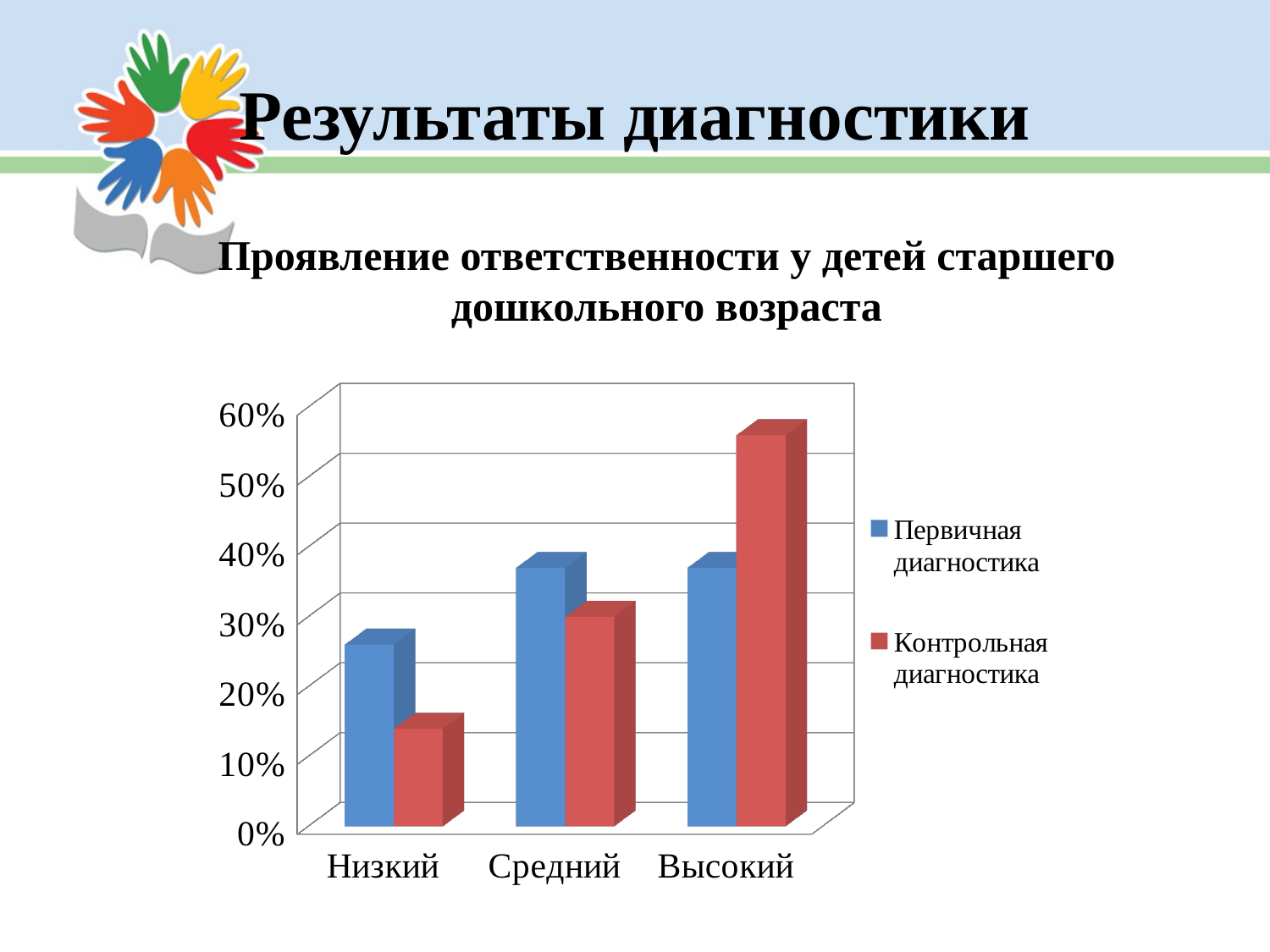
What colour are the bars for Контрольная диагностика in the chart? red Which category has the lowest value for Первичная диагностика? Низкий Is the value for Контрольная диагностика in the Высокий category greater or less than 50%? greater Which category has the lowest value for Контрольная диагностика? Низкий How many series does the chart's legend list? 2 For the Низкий category, which series has the larger value: Первичная диагностика or Контрольная диагностика? Первичная диагностика Which category has the highest value for Контрольная диагностика? Высокий Is the value for Первичная диагностика in the Средний category greater or less than 30%? greater How many categories are shown on the x axis of the chart? 3 Is the value for Контрольная диагностика in the Низкий category greater or less than 20%? less For the Высокий category, which series has the larger value: Первичная диагностика or Контрольная диагностика? Контрольная диагностика What kind of chart is shown on the slide? bar chart